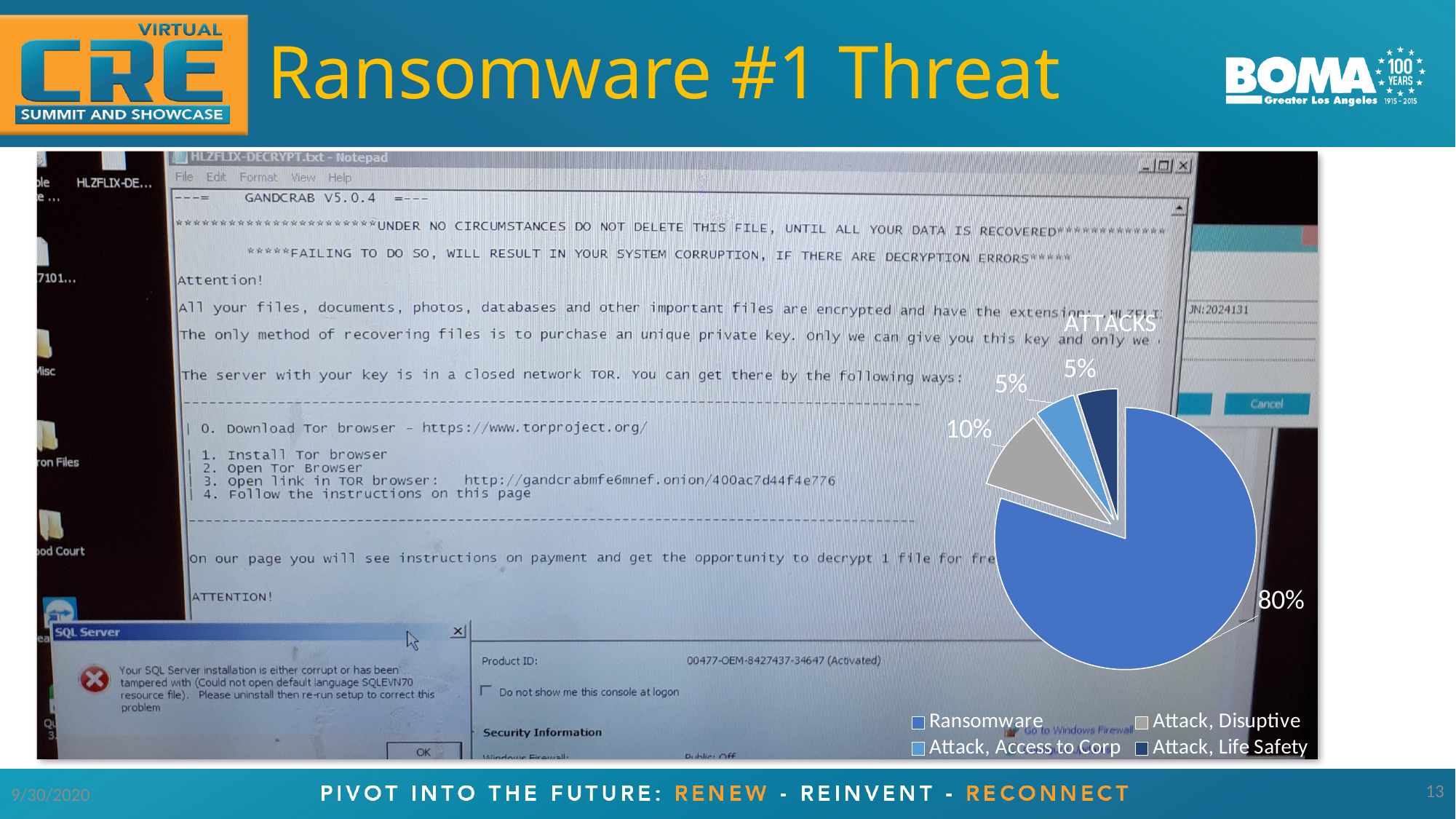
What is the combined share of the Attack, Access to Corp and Attack, Life Safety slices? 10% What is the difference in percentage points between the Ransomware slice and the Attack, Disruptive slice? 70 What share of attacks does the Attack, Access to Corp slice represent? 5% What kind of chart is shown on the slide? pie chart Which category has the largest slice of the pie chart? Ransomware What share of attacks does the Attack, Disruptive slice represent? 10% Is the Ransomware share greater or less than 50%? greater What share of attacks does the Attack, Life Safety slice represent? 5% Which is larger, the Attack, Disruptive slice or the Attack, Life Safety slice? Attack, Disruptive What is the title of the pie chart? ATTACKS What share of attacks does the Ransomware slice represent? 80% How many categories does the legend of the pie chart list? 4